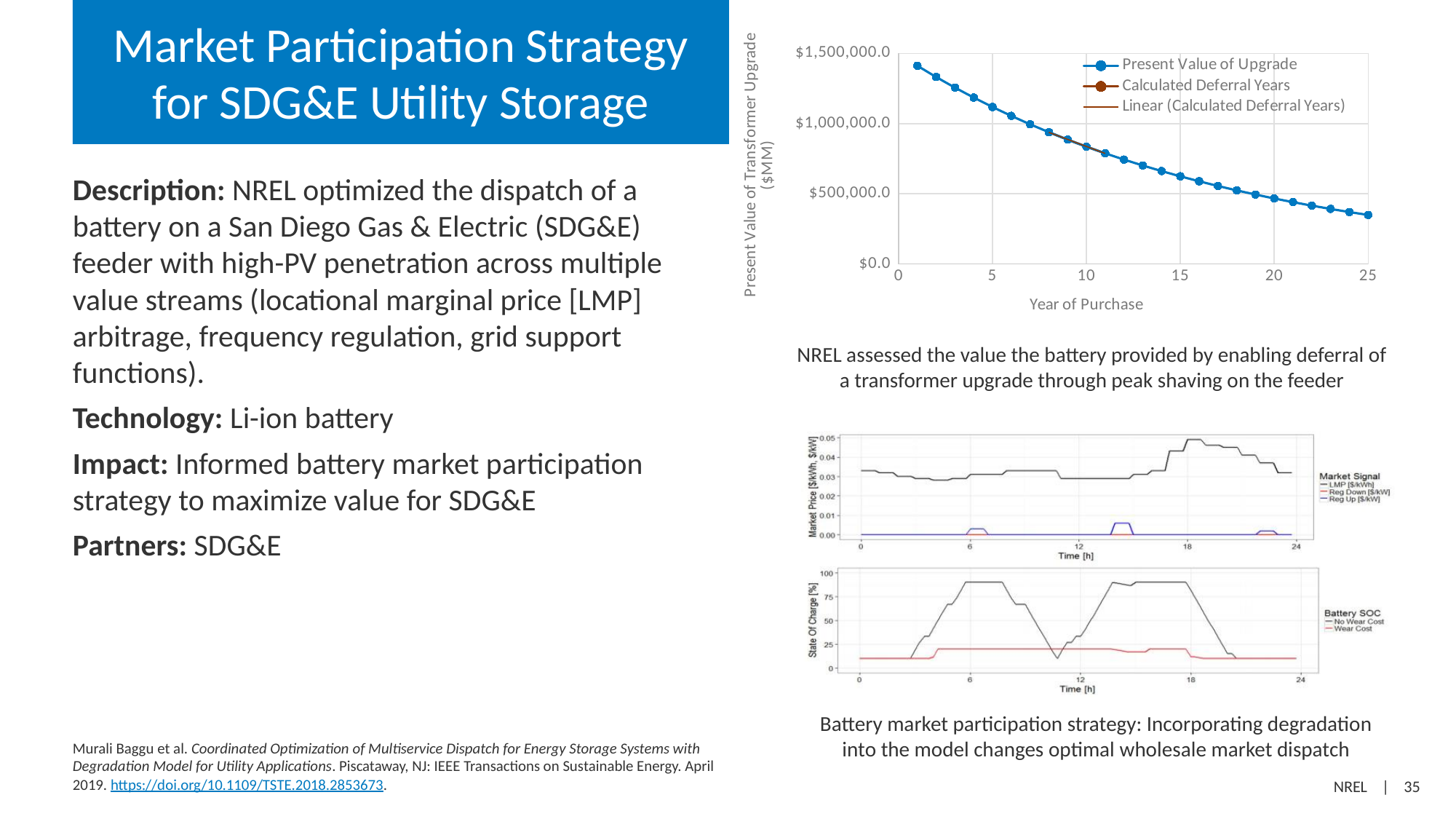
In the top-right chart, what is the label of the x axis? Year of Purchase In the bottom-right Battery SOC chart, how many series does the legend list? 2 In the top-right chart, is the Present Value of Upgrade at year 10 greater or less than $1,000,000.0? less In the top-right chart, is the Present Value of Upgrade at year 1 greater or less than $1,000,000.0? greater In the top-right chart, is the Present Value of Upgrade at year 25 greater or less than $500,000.0? less In the top-right chart, what kind of chart is used to show Present Value of Transformer Upgrade against Year of Purchase? line chart In the top-right chart, does the Present Value of Upgrade rise or fall as Year of Purchase increases? fall In the top-right chart, which year of purchase has the lowest Present Value of Upgrade? 25 In the top-right chart, which is larger: the Present Value of Upgrade at year 5 or at year 20? year 5 In the top-right chart, how many entries does the legend list? 3 In the top-right chart, which year of purchase has the highest Present Value of Upgrade? 1